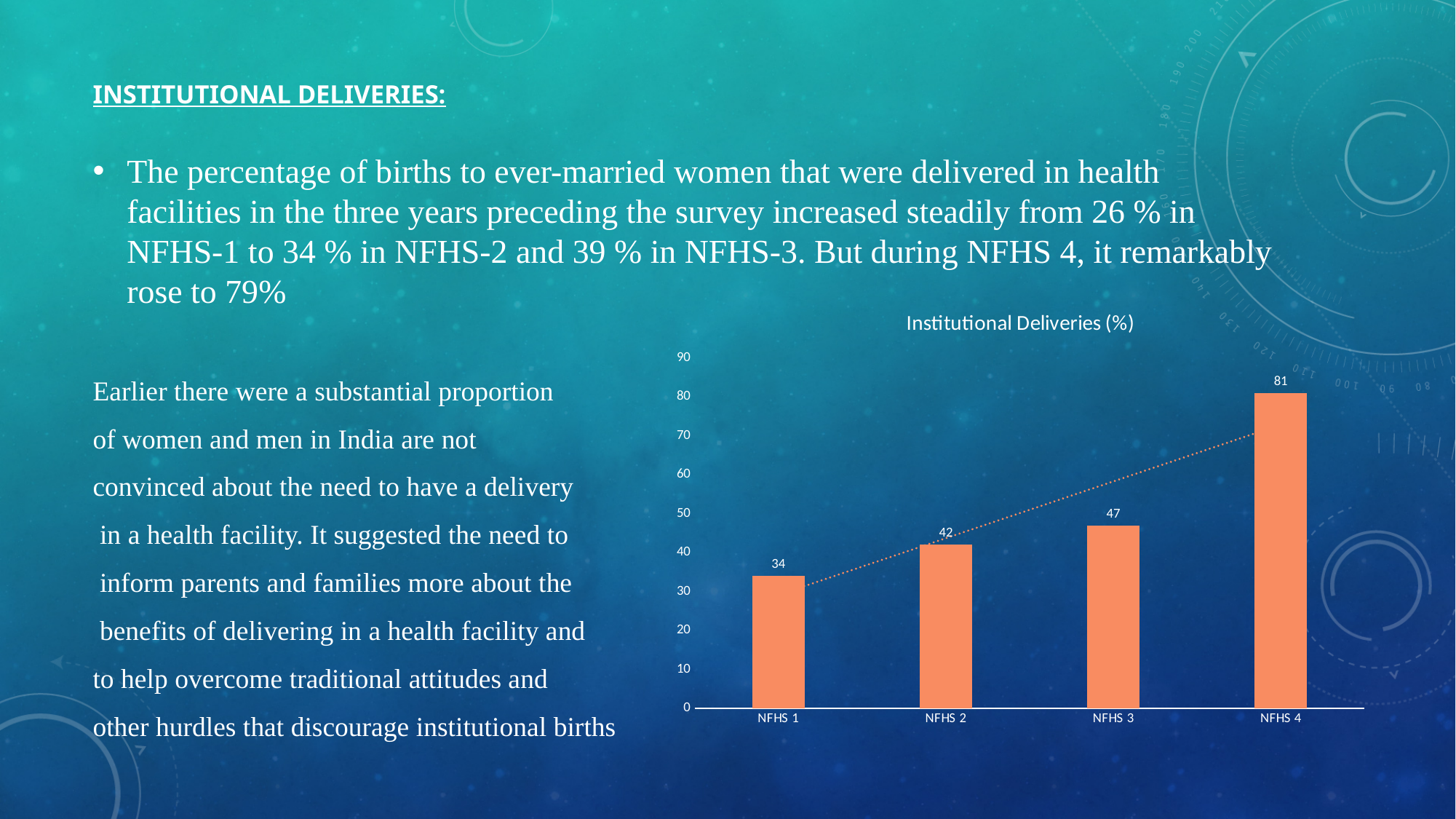
What is the title of the chart on the slide? Institutional Deliveries (%) What is the value for NFHS 4 in the Institutional Deliveries (%) chart? 81 Which is larger, the value for NFHS 2 or the value for NFHS 3? NFHS 3 What is the value for NFHS 2 in the Institutional Deliveries (%) chart? 42 Do the values rise or fall from NFHS 1 to NFHS 4? Rise How many survey rounds are shown on the x axis of the chart? 4 What is the value for NFHS 1 in the Institutional Deliveries (%) chart? 34 What is the value for NFHS 3 in the Institutional Deliveries (%) chart? 47 Which survey round has the highest value in the chart? NFHS 4 Which survey round has the lowest value in the chart? NFHS 1 What kind of chart is shown on the slide? Bar chart What is the difference between the values for NFHS 4 and NFHS 3? 34